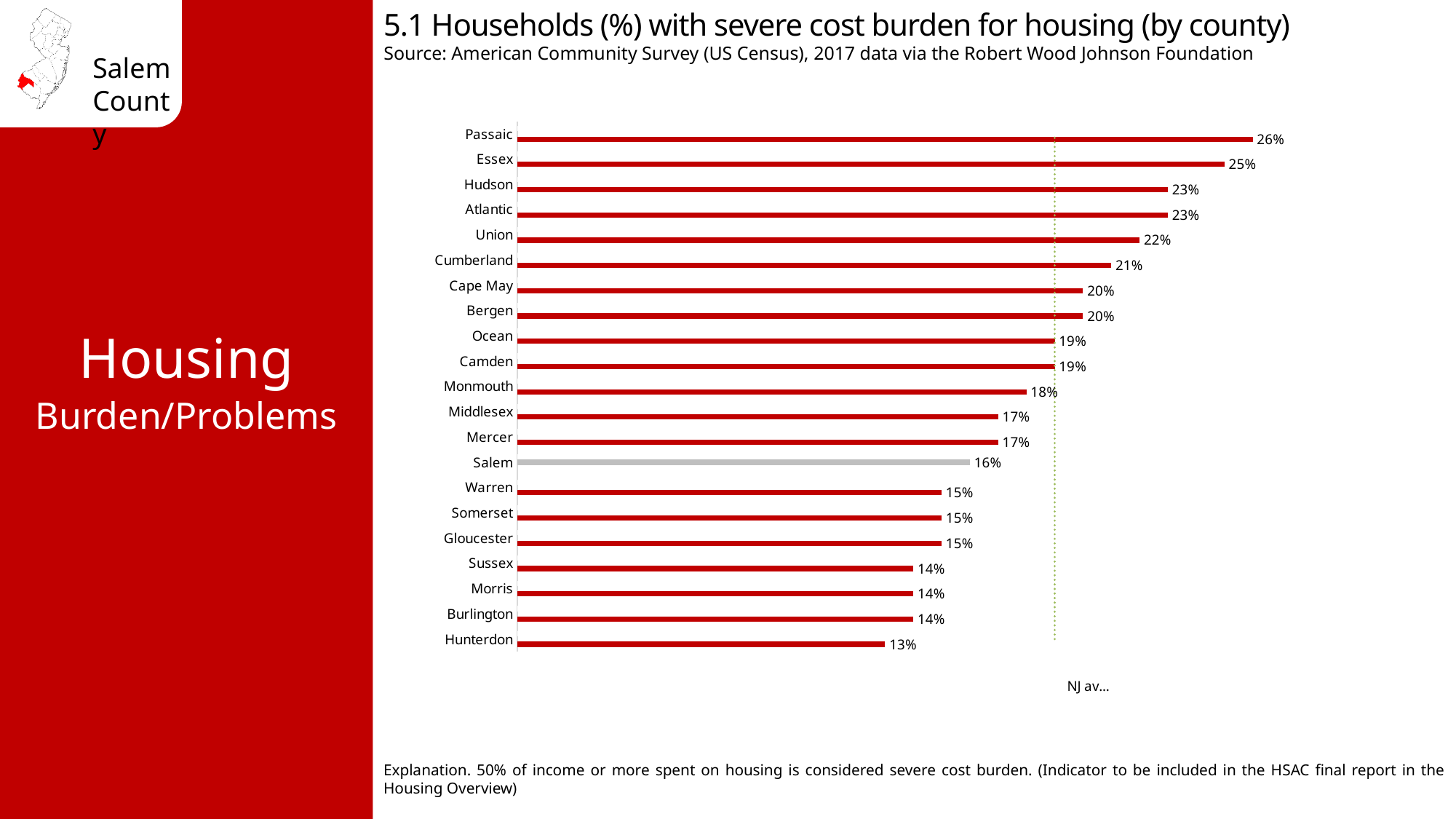
Which is larger, the value for Union or the value for Gloucester? Union What is the title of the chart? 5.1 Households (%) with severe cost burden for housing (by county) What is the value for Cumberland? 21% What is the difference between the values for Essex and Hunterdon? 12% What kind of chart is this? Bar chart What is the difference between the values for Passaic and Salem? 10% Which county has the lowest value? Hunterdon Which county has the highest value? Passaic Which county's bar is shown in grey rather than red? Salem What is the value for Salem? 16% What is the value for Passaic? 26% How many counties are shown in the chart? 21